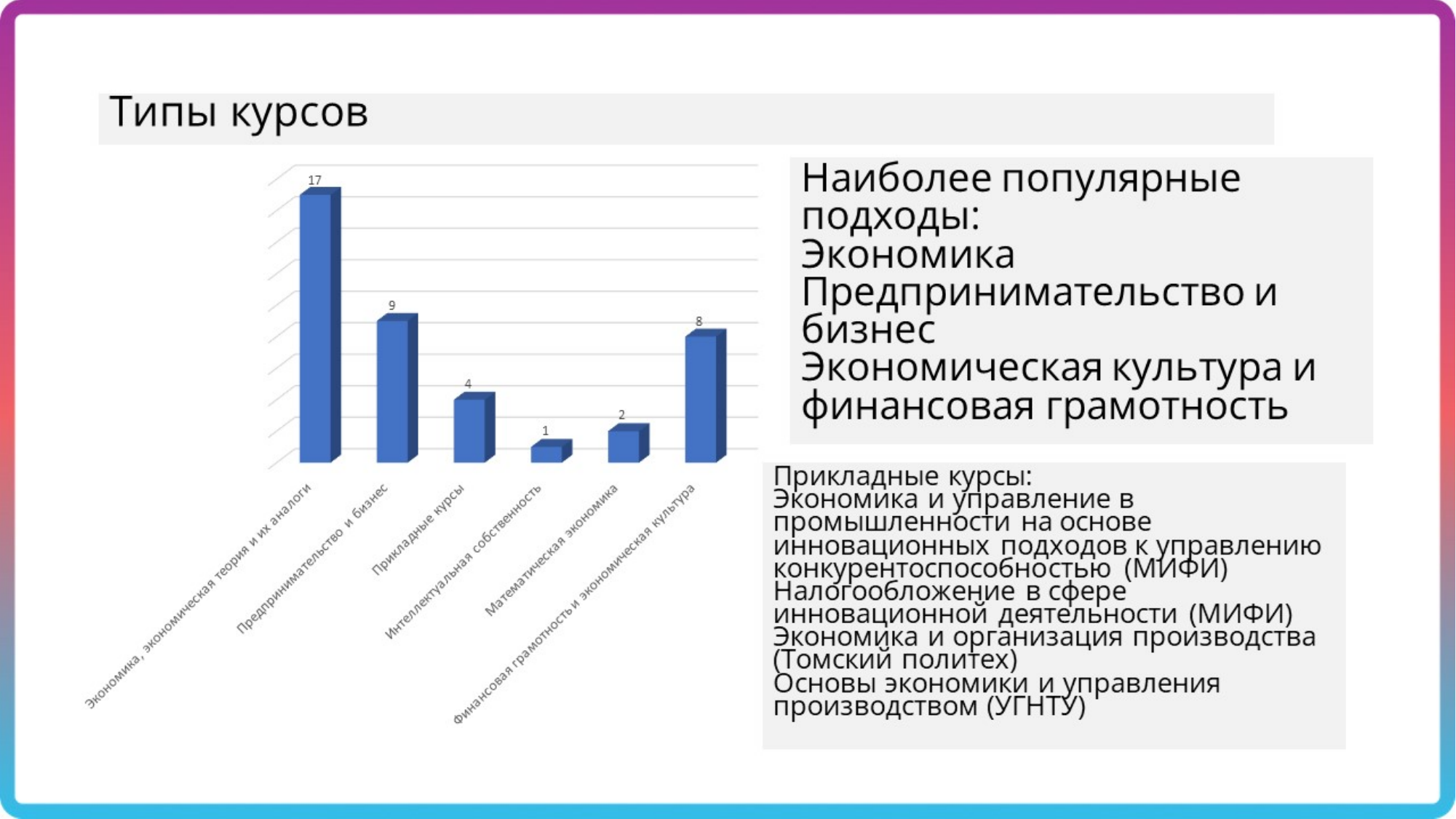
How many categories are shown in the chart? 6 What is the value for Финансовая грамотность и экономическая культура? 8 What is the value for Предпринимательство и бизнес? 9 What is the difference between the values for Экономика, экономическая теория и их аналоги and Предпринимательство и бизнес? 8 What is the title of the slide containing the chart? Типы курсов Which category has the highest value? Экономика, экономическая теория и их аналоги What is the value for Математическая экономика? 2 What kind of chart is shown on the slide? Bar chart Which is larger: the value for Предпринимательство и бизнес or the value for Финансовая грамотность и экономическая культура? Предпринимательство и бизнес What is the value for Прикладные курсы? 4 Which category has the lowest value? Интеллектуальная собственность What is the value for Интеллектуальная собственность? 1